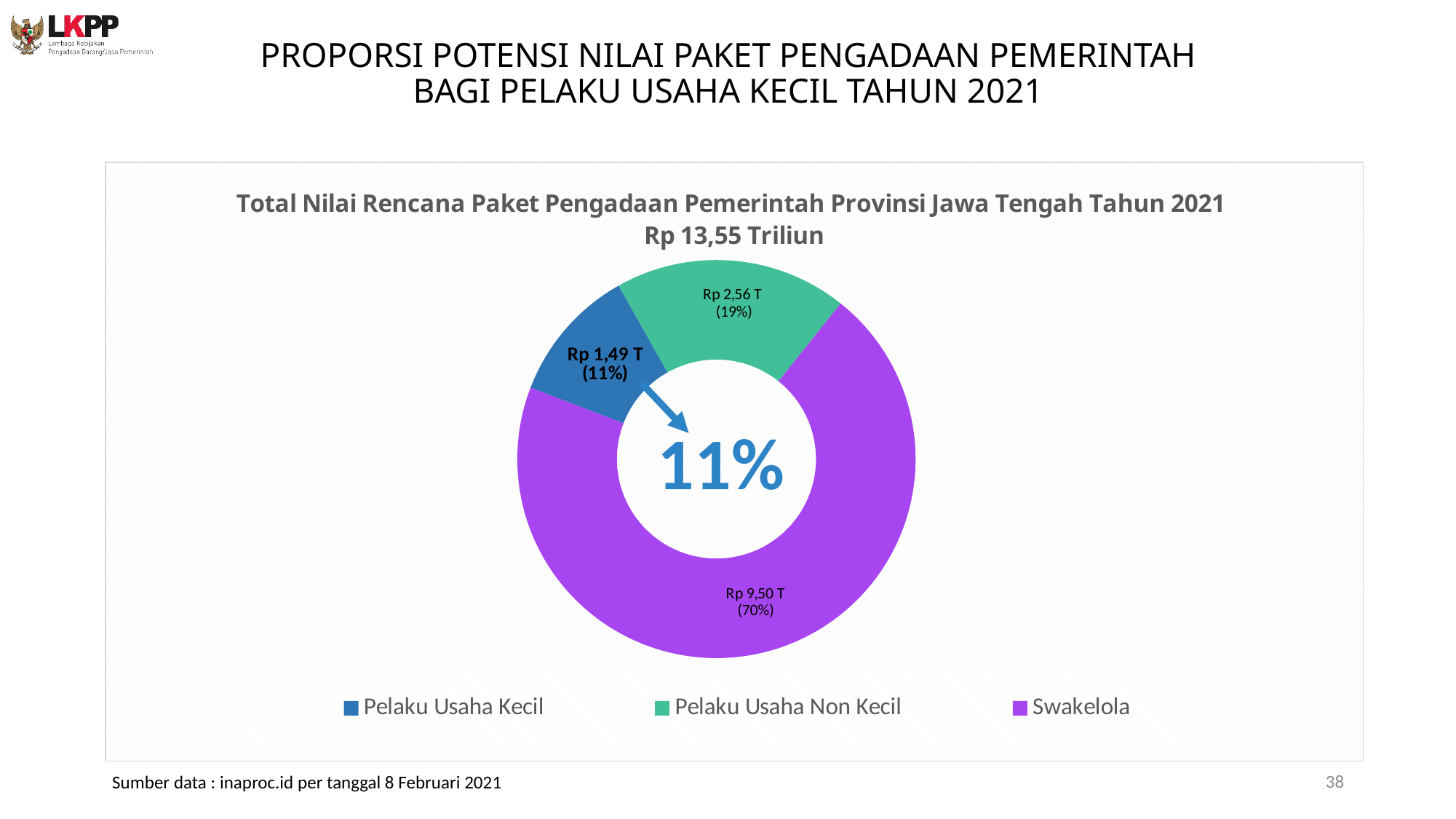
What kind of chart is shown on the slide? Doughnut (pie) chart What is the value for Pelaku Usaha Kecil? Rp 1,49 T Which is larger, Pelaku Usaha Non Kecil or Pelaku Usaha Kecil? Pelaku Usaha Non Kecil What is the value for Pelaku Usaha Non Kecil? Rp 2,56 T How many categories does the legend list? 3 What is the difference in value between Swakelola and Pelaku Usaha Non Kecil? Rp 6,94 T Which category has the smallest slice? Pelaku Usaha Kecil What is the value for Swakelola? Rp 9,50 T Which category has the largest slice? Swakelola What share of the chart does Swakelola represent? 70% What total value is stated in the chart title? Rp 13,55 Triliun What share of the chart does Pelaku Usaha Non Kecil represent? 19%